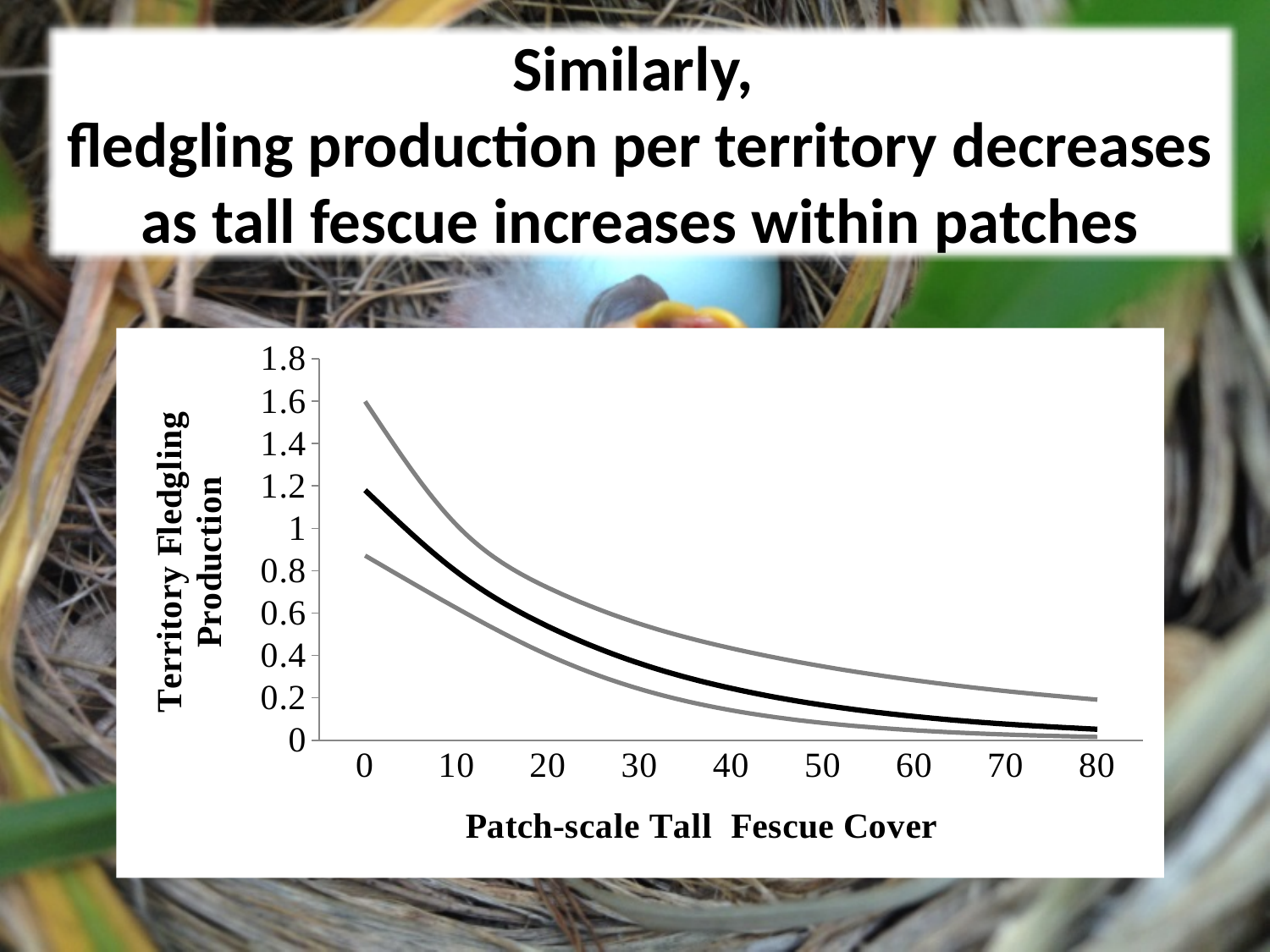
Is the value of the black line at a Patch-scale Tall Fescue Cover of 60 greater or less than 0.2? less What is the title of the x axis? Patch-scale Tall Fescue Cover What kind of chart is shown on the slide? line chart Is the value of the black line at a Patch-scale Tall Fescue Cover of 0 greater or less than 1? greater What is the highest value shown on the y axis? 1.8 Does the black line rise or fall as Patch-scale Tall Fescue Cover increases from 0 to 80? fall Is the value of the lower gray line at a Patch-scale Tall Fescue Cover of 0 greater or less than 1? less What is the title of the y axis? Territory Fledgling Production How many lines are plotted on the chart? 3 At a Patch-scale Tall Fescue Cover of 0, which line has the higher value: the black line or the lower gray line? the black line